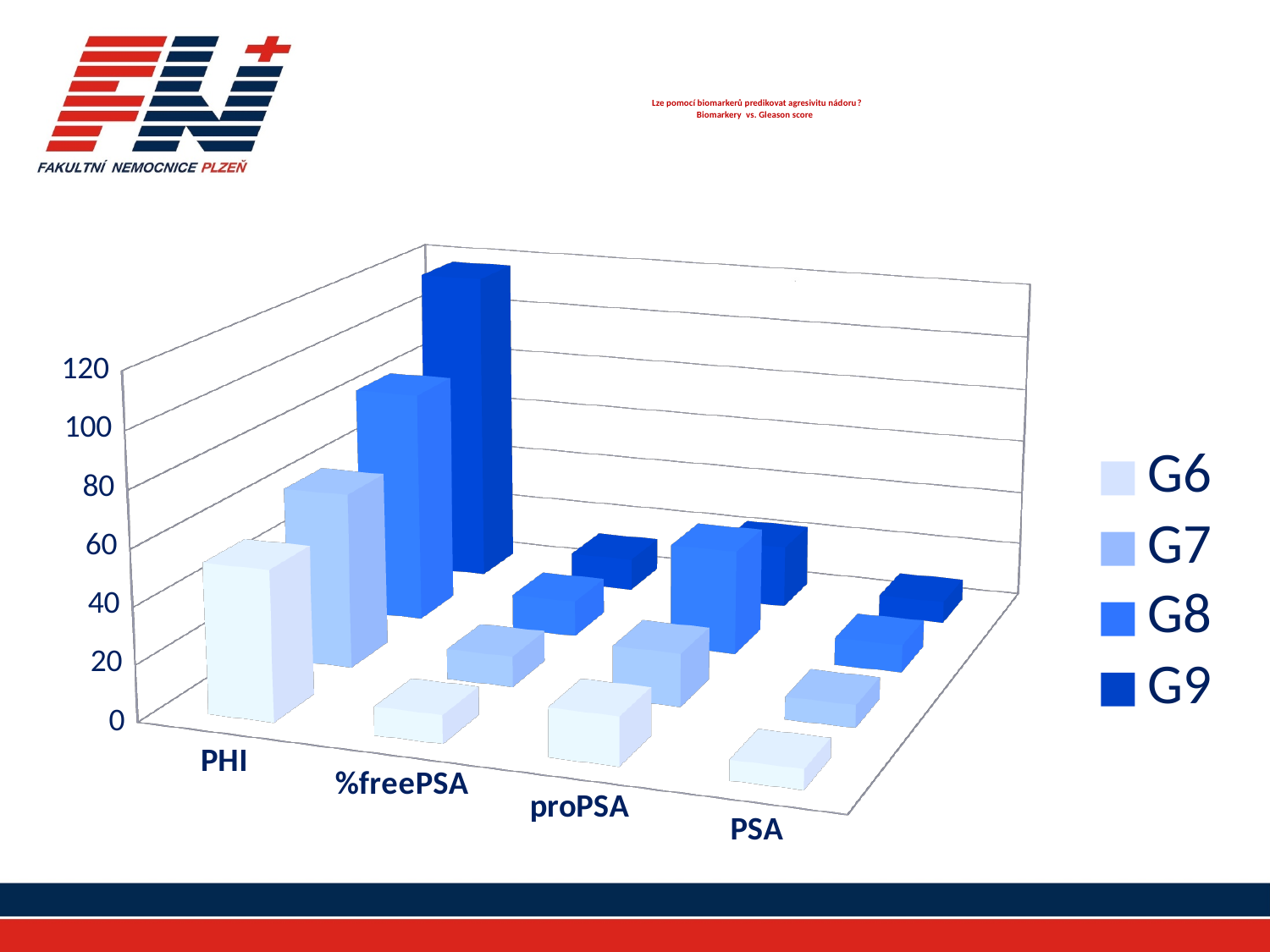
Which biomarker category has the tallest bar in the chart? PHI Which biomarker category has the lowest bars overall in the chart? PSA Which series has the tallest bar for PHI? G9 Is the G6 value for PSA greater or less than 20? less How many biomarker categories are shown on the x axis of the chart? 4 How many series does the chart legend list? 4 For PHI, do the values rise or fall going from G6 to G9? rise Which series is drawn in the darkest blue in the chart? G9 Is the G9 value for PHI greater or less than 80? greater Which series are listed in the chart legend? G6, G7, G8, G9 What kind of chart is shown on the slide? bar chart Which is larger, the G9 value for PHI or the G9 value for PSA? PHI